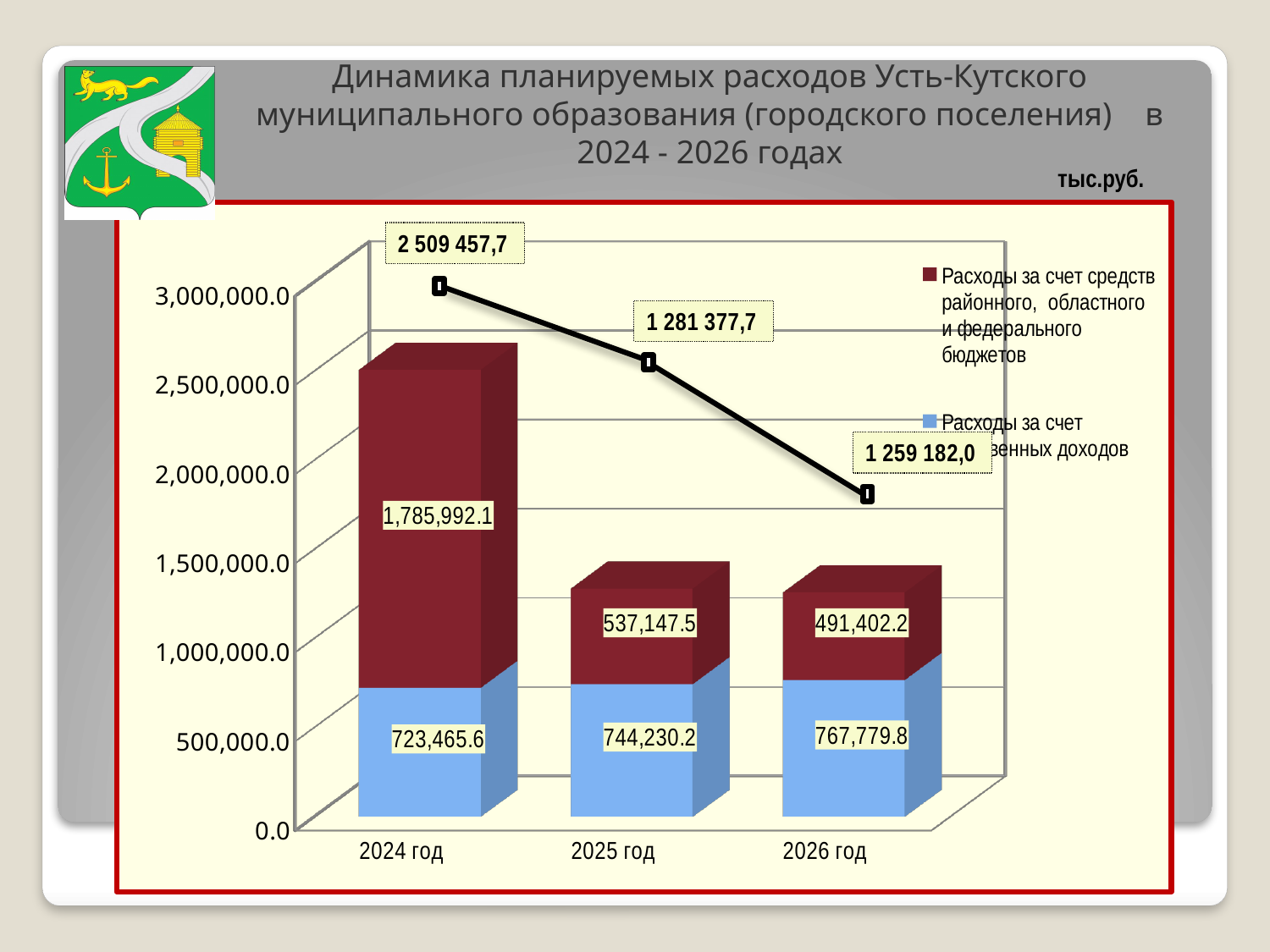
What is the difference between the 'Расходы за счет средств районного, областного и федерального бюджетов' values for 2025 год and 2026 год? 45,745.3 For 2025 год, which segment is larger: the dark red segment or the blue segment? the blue segment (744,230.2) What is the value of the 'Расходы за счет средств районного, областного и федерального бюджетов' segment for 2024 год? 1,785,992.1 What unit of measurement is indicated above the chart? тыс.руб. What kind of chart is shown on the slide? stacked bar chart with a line Which year has the highest value for 'Расходы за счет средств районного, областного и федерального бюджетов'? 2024 год How many years (categories) are shown on the x axis? 3 Does the 'Расходы за счет средств районного, областного и федерального бюджетов' value rise or fall from 2024 год to 2026 год? fall How many series does the legend list? 2 What is the value of the blue (lower) segment for 2026 год? 767,779.8 Which year has the lowest value for the blue (lower) segment? 2024 год What is the total of the stacked bar for 2024 год, as shown by the line label? 2 509 457,7